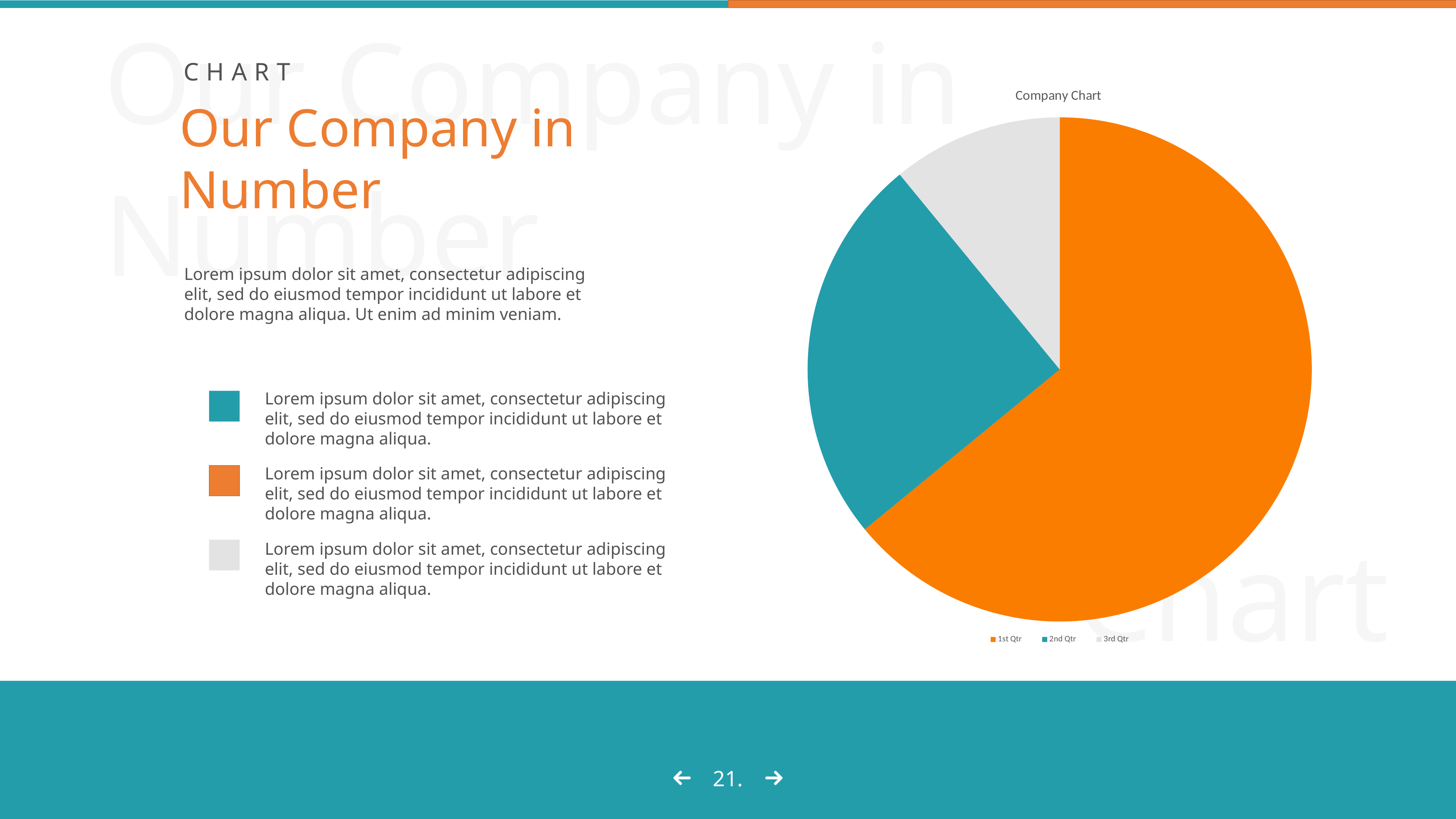
How many slices does the pie chart have? 3 Which category has the largest slice of the pie? 1st Qtr What is the title of the chart? Company Chart How many entries does the chart legend list? 3 What colour is the 2nd Qtr slice in the pie chart? teal Which slice is larger, 1st Qtr or 2nd Qtr? 1st Qtr What kind of chart is shown on the slide? pie chart Which category has the smallest slice of the pie? 3rd Qtr Which slice is larger, 2nd Qtr or 3rd Qtr? 2nd Qtr